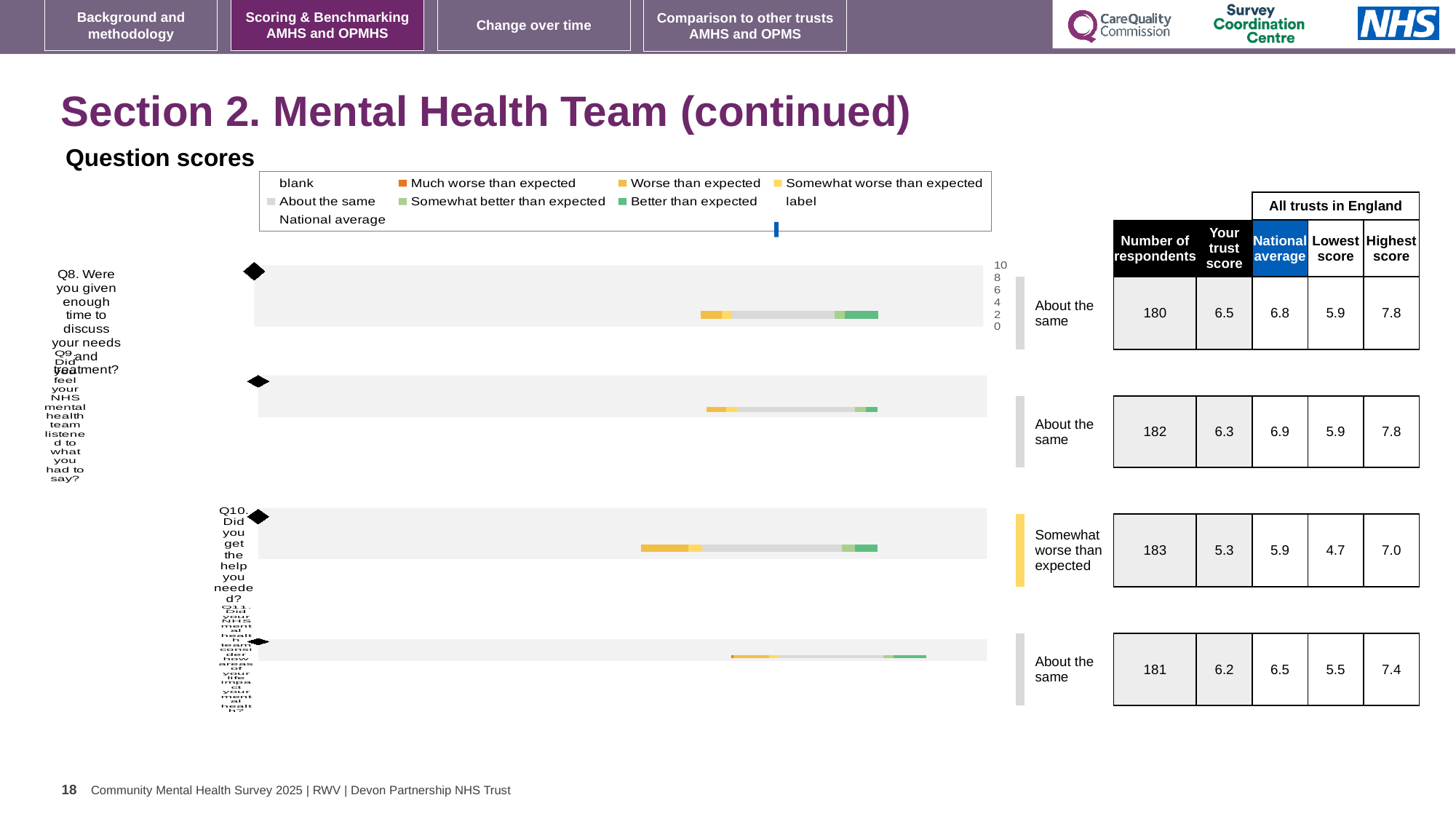
Which question (Q8 to Q11) has the highest 'Your trust score'? Q8 What kind of chart is used to show the Q8 question score? bar chart How many question charts (Q8 to Q11) are shown on the slide? 4 What is the highest tick value on the axis of the Q8 chart? 10 In the table beside the Q10 chart, what is the National average score? 5.9 For Q10, which is larger: the trust score or the National average? National average Which legend entry is shown in orange? Much worse than expected How many respondents are listed for Q11? 181 In the table beside the Q8 chart, what is the 'Your trust score' value? 6.5 For Q9, what is the difference between the National average (6.9) and the trust score (6.3)? 0.6 What benchmark category label is shown next to the Q10 chart? Somewhat worse than expected Which question (Q8 to Q11) has the lowest 'Your trust score'? Q10